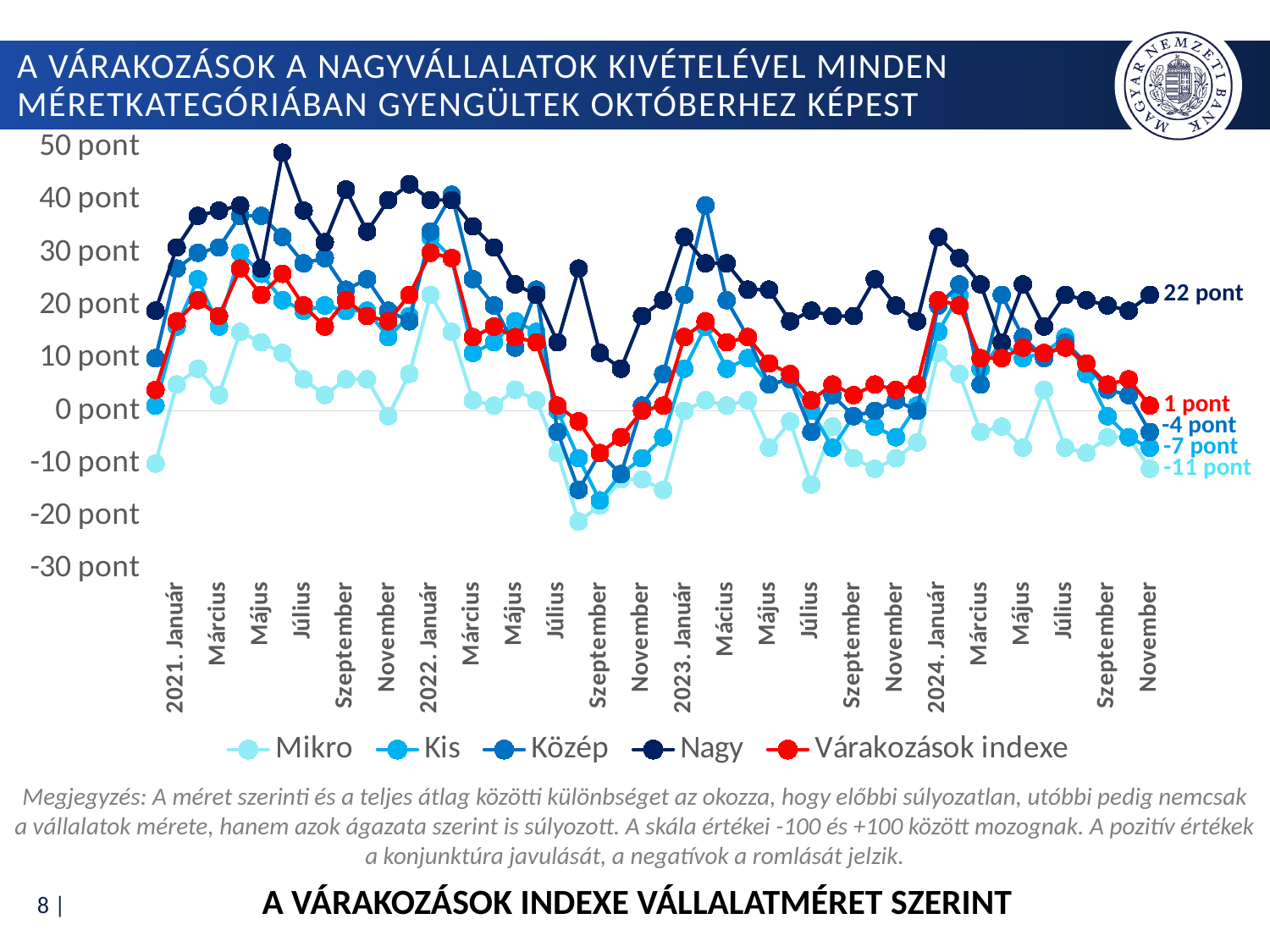
At the last data point (November 2024), which is larger: the Kis value or the Közép value? Közép What kind of chart is shown on the slide? Line chart What is the difference between the Nagy and Mikro values at the last data point (November 2024)? 33 pont Which series has the highest value at the last data point (November 2024)? Nagy What is the value of the Kis series at the last data point (November 2024)? -7 pont What is the value of the Mikro series at the last data point (November 2024)? -11 pont What is the value of the Közép series at the last data point (November 2024)? -4 pont What is the value of the Nagy series at the last data point (November 2024)? 22 pont What is the value of the Várakozások indexe series at the last data point (November 2024)? 1 pont Which series has the lowest value at the last data point (November 2024)? Mikro How many series does the legend list? 5